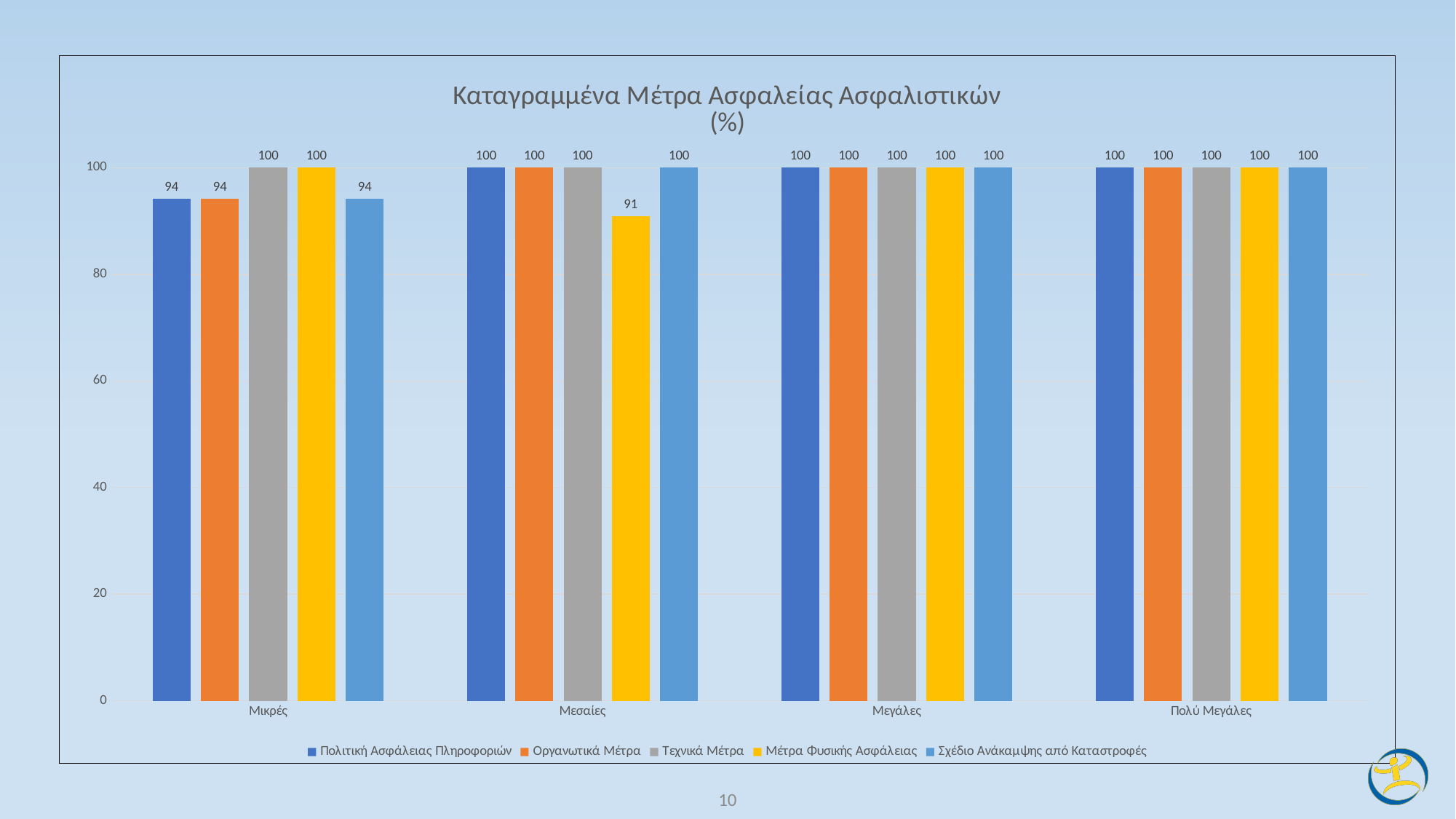
How many series does the legend list? 5 What is the title of the chart? Καταγραμμένα Μέτρα Ασφαλείας Ασφαλιστικών (%) What is the difference between the Τεχνικά Μέτρα value and the Πολιτική Ασφάλειας Πληροφοριών value in the Μικρές category? 6 What is the value for Τεχνικά Μέτρα in the Μικρές category? 100 Which series has the lowest value in the Μεσαίες category? Μέτρα Φυσικής Ασφάλειας Which is larger in the Μικρές category: Οργανωτικά Μέτρα or Μέτρα Φυσικής Ασφάλειας? Μέτρα Φυσικής Ασφάλειας What is the value for Μέτρα Φυσικής Ασφάλειας in the Μεσαίες category? 91 What is the value for Πολιτική Ασφάλειας Πληροφοριών in the Μικρές category? 94 What is the difference between the Μέτρα Φυσικής Ασφάλειας value in Μεγάλες and in Μεσαίες? 9 How many categories are shown on the x axis? 4 What is the value for Σχέδιο Ανάκαμψης από Καταστροφές in the Μεγάλες category? 100 What kind of chart is shown on the slide? Bar chart